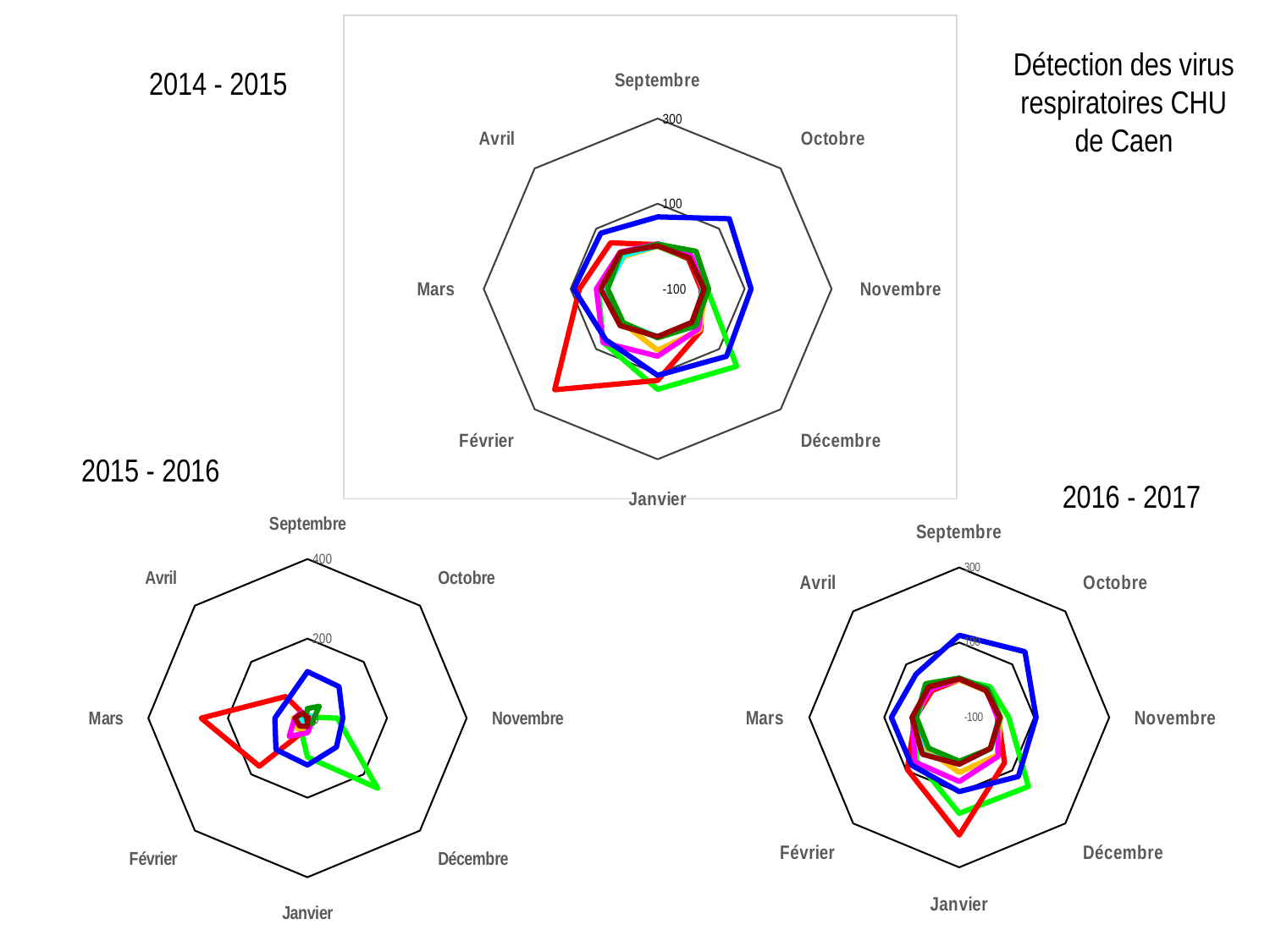
In the 2015 - 2016 chart, is the value of the green series for Décembre greater or less than 200? greater In the 2016 - 2017 chart, is the value of the red series for Janvier greater or less than 300? less How many month categories does the 2016 - 2017 chart have? 8 In the 2015 - 2016 chart, is the value of the green series for Décembre greater or less than 400? less What is the overall title given for the charts on the slide? Détection des virus respiratoires CHU de Caen What kind of chart is the 2014 - 2015 chart? radar chart What is the highest axis value shown on the 2015 - 2016 chart? 400 How many month categories does the 2015 - 2016 chart have? 8